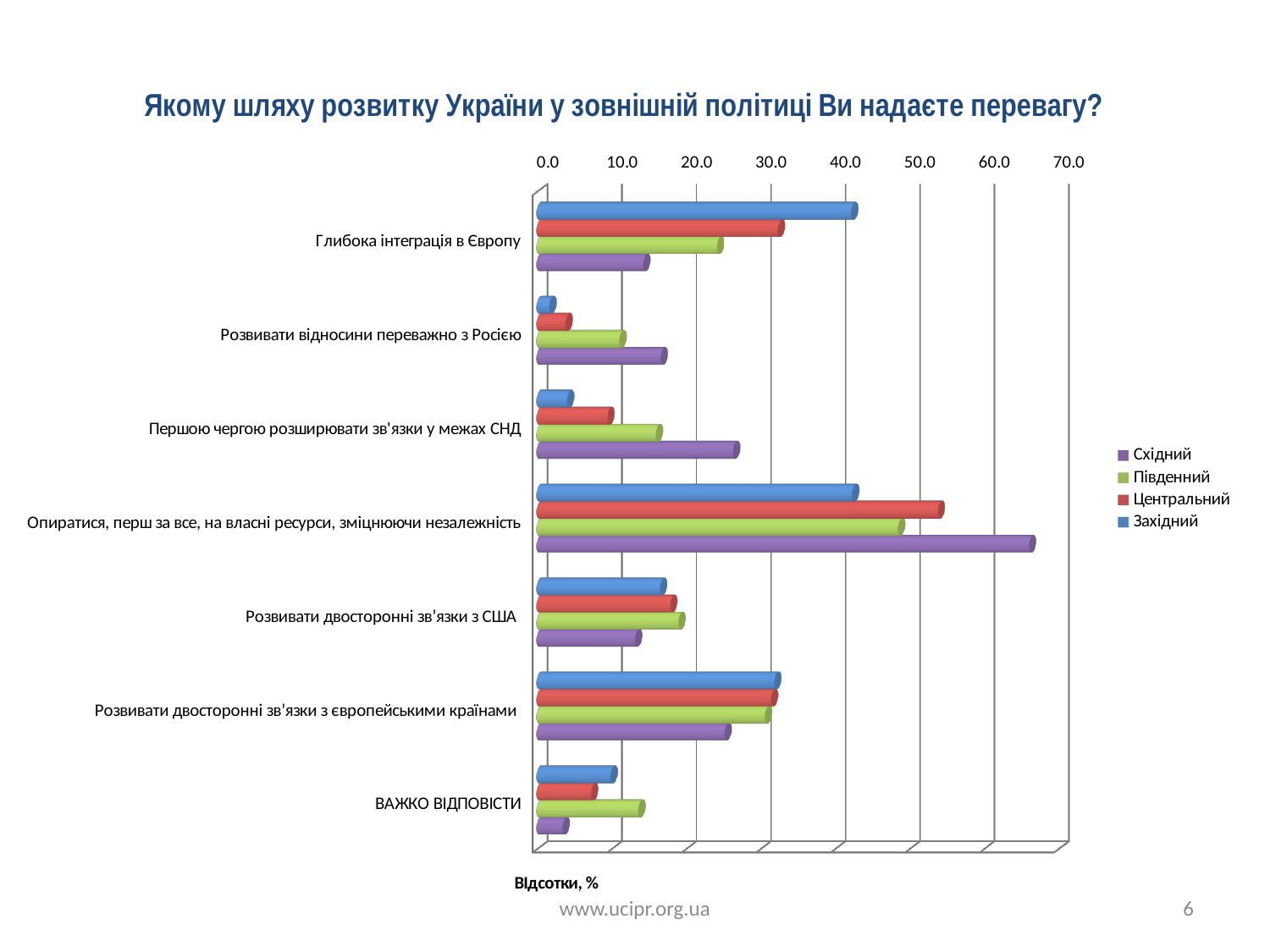
What kind of chart is shown on the slide? bar chart For 'Першою чергою розширювати зв'язки у межах СНД', which is larger: the Східний value or the Західний value? Східний How many categories (answer options) are plotted on the chart? 7 Is the Східний value for 'Опиратися, перш за все, на власні ресурси, зміцнюючи незалежність' greater or less than 60.0? greater What is the label of the horizontal axis? Відсотки, % Is the Східний value for 'ВАЖКО ВІДПОВІСТИ' greater or less than 10.0? less How many series does the legend list? 4 For the Східний series, which category has the highest value? Опиратися, перш за все, на власні ресурси, зміцнюючи незалежність For the Західний series, which category has the lowest value? Розвивати відносини переважно з Росією For 'Глибока інтеграція в Європу', which is larger: the Західний value or the Східний value? Західний Is the Західний value for 'Глибока інтеграція в Європу' greater or less than 40.0? greater Which series are listed in the legend? Східний, Південний, Центральний, Західний